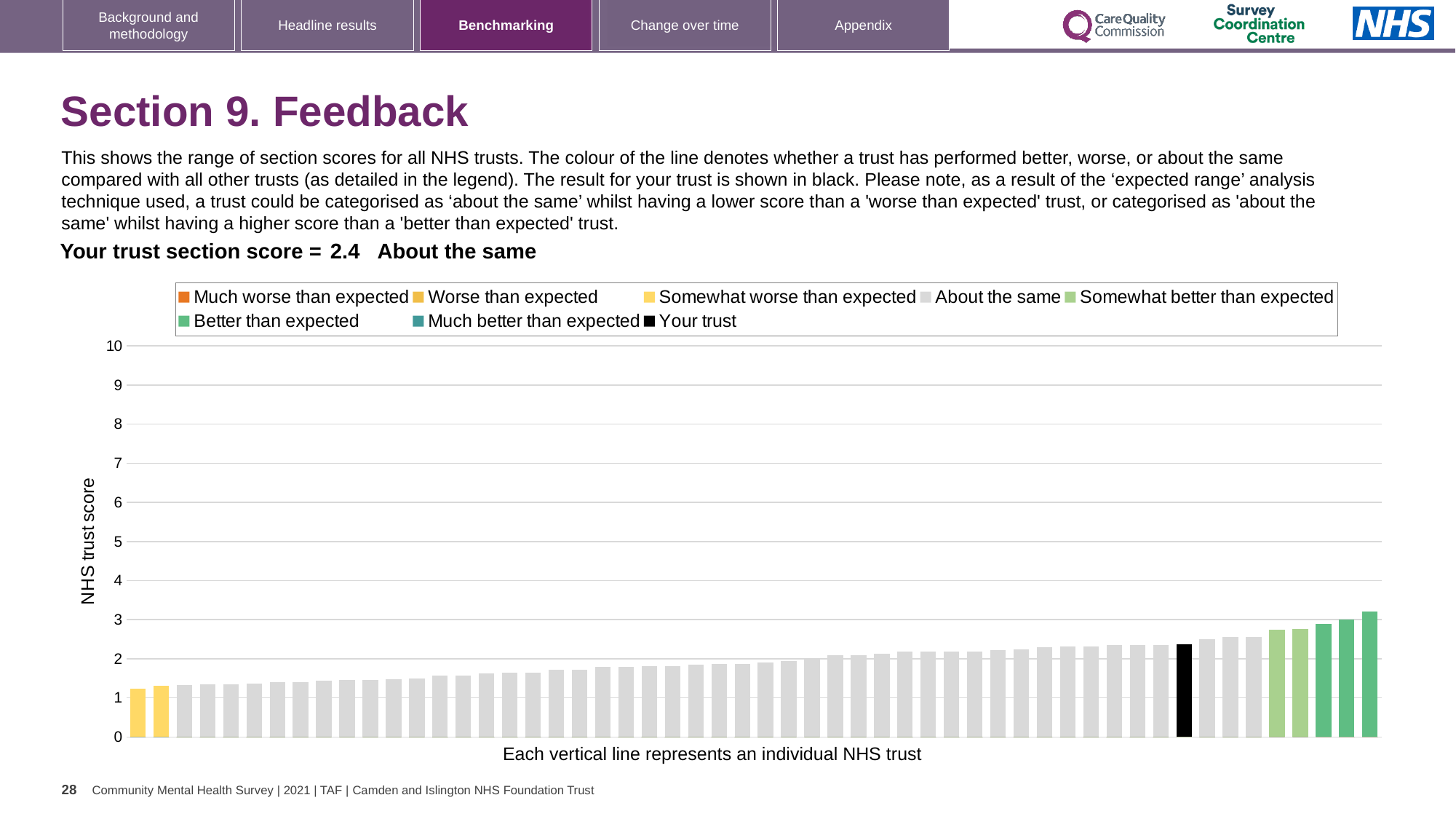
Is the value for your trust (the black bar) greater or less than 2? greater Is the value of the lowest bar (leftmost trust) greater or less than 1? greater Which performance category is your trust placed in for this section? About the same What is the section score for your trust? 2.4 How many entries does the chart legend list? 8 What kind of chart is shown on the slide? bar chart Is the value for your trust (the black bar) greater or less than 3? less Do the bar values rise or fall from left to right along the x axis? rise What is the label on the y axis of the chart? NHS trust score What colour is the bar representing your trust? black